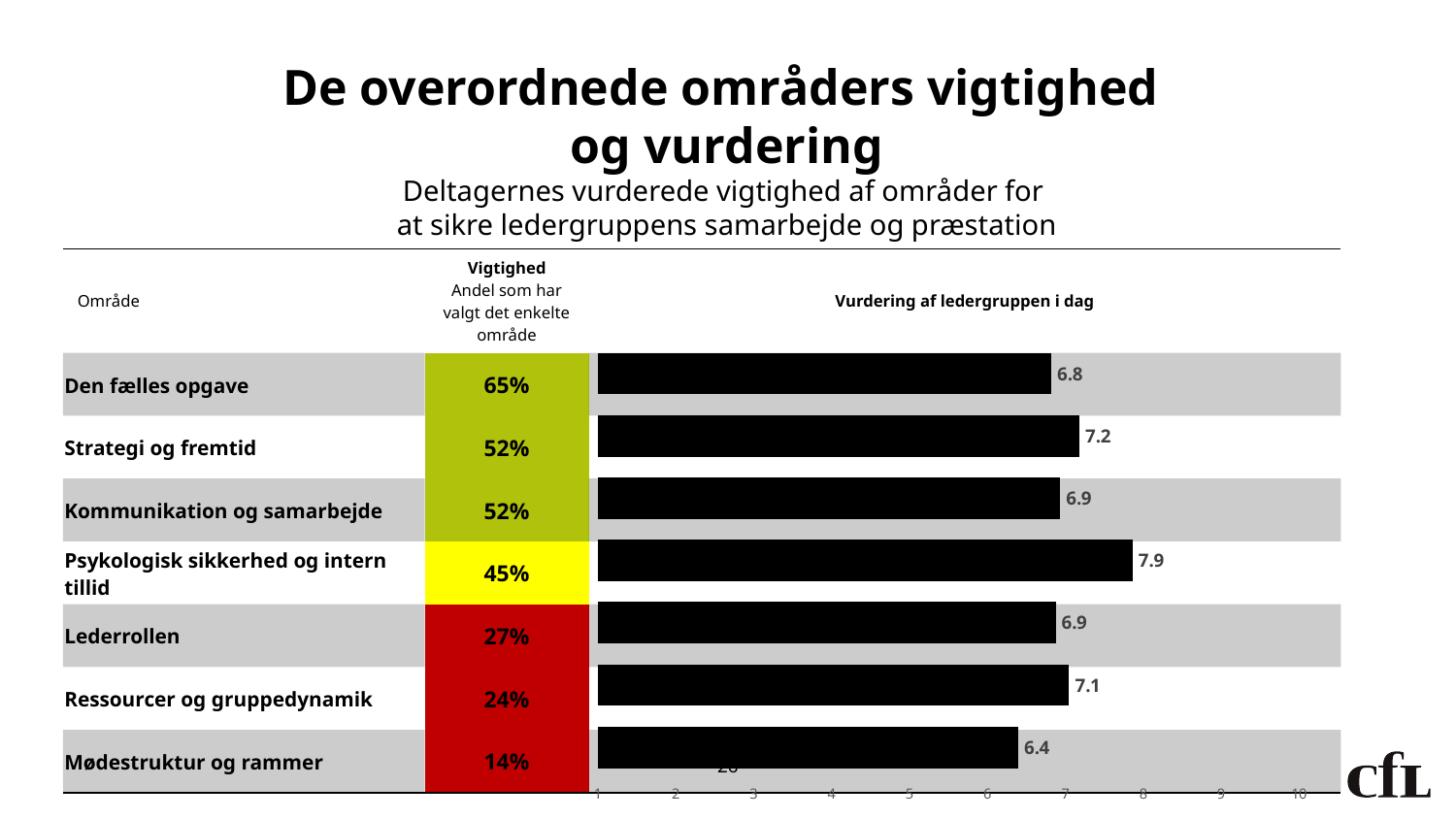
What is the difference between the ratings for Ressourcer og gruppedynamik and Lederrollen? 0.2 What is the rating for Strategi og fremtid in the "Vurdering af ledergruppen i dag" chart? 7.2 Is the rating for Ressourcer og gruppedynamik greater or less than 7? greater What is the difference between the ratings for Psykologisk sikkerhed og intern tillid and Mødestruktur og rammer? 1.5 Which area has the highest rating in the "Vurdering af ledergruppen i dag" chart? Psykologisk sikkerhed og intern tillid What is the rating for Psykologisk sikkerhed og intern tillid in the "Vurdering af ledergruppen i dag" chart? 7.9 What is the Vigtighed percentage shown for Den fælles opgave? 65% What is the rating for Mødestruktur og rammer in the "Vurdering af ledergruppen i dag" chart? 6.4 Which area has the lowest rating in the "Vurdering af ledergruppen i dag" chart? Mødestruktur og rammer How many areas are rated in the "Vurdering af ledergruppen i dag" chart? 7 What kind of chart is shown under "Vurdering af ledergruppen i dag"? bar chart Which has a higher rating: Strategi og fremtid or Den fælles opgave? Strategi og fremtid